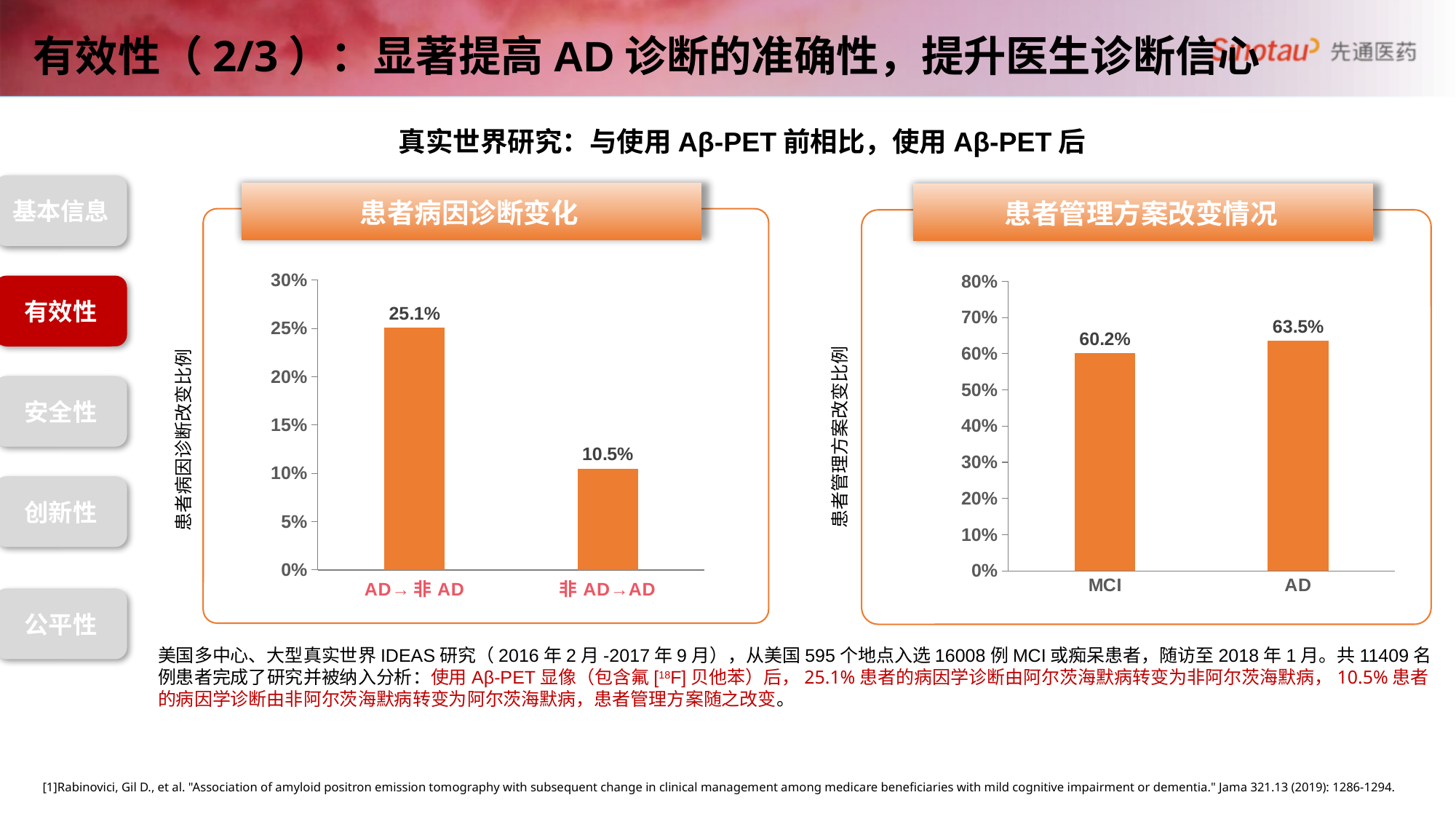
In the right chart (患者管理方案改变情况), what is the value for MCI? 60.2% In the left chart (患者病因诊断变化), which category has the highest value? AD→非AD In the left chart (患者病因诊断变化), what is the difference between the AD→非AD and 非AD→AD values? 14.6% What is the y-axis label of the left chart (患者病因诊断变化)? 患者病因诊断改变比例 What type of chart is the right chart (患者管理方案改变情况)? Bar chart In the left chart (患者病因诊断变化), what is the value for AD→非AD? 25.1% In the right chart (患者管理方案改变情况), what is the difference between the AD and MCI values? 3.3% In the right chart (患者管理方案改变情况), what is the value for AD? 63.5% In the left chart (患者病因诊断变化), what is the value for 非AD→AD? 10.5% In the right chart (患者管理方案改变情况), which category has the lowest value? MCI In the right chart (患者管理方案改变情况), is the value for MCI greater or less than 50%? greater How many categories are shown in the left chart (患者病因诊断变化)? 2